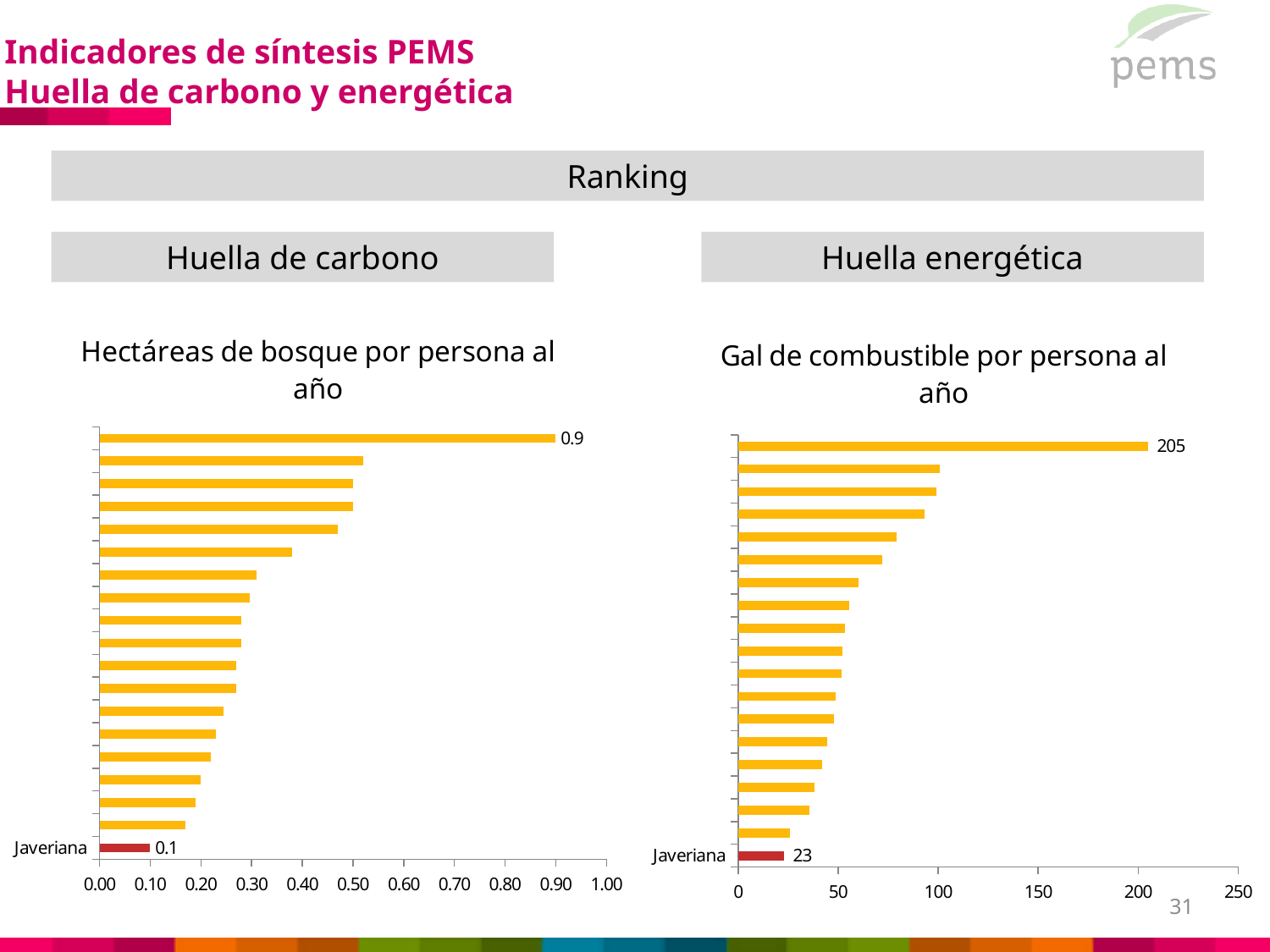
In the 'Hectáreas de bosque por persona al año' chart, what is the value for Javeriana? 0.1 In the 'Gal de combustible por persona al año' chart, what is the value of the longest bar? 205 In the 'Hectáreas de bosque por persona al año' chart, what colour is the Javeriana bar? red In the 'Hectáreas de bosque por persona al año' chart, which labelled category has the lowest value? Javeriana In the 'Hectáreas de bosque por persona al año' chart, what is the difference between the highest value and the value for Javeriana? 0.8 How many bars are plotted in the 'Gal de combustible por persona al año' chart? 19 In the 'Gal de combustible por persona al año' chart, what is the difference between the highest value and the value for Javeriana? 182 What kind of chart is the 'Gal de combustible por persona al año' chart? bar chart In the 'Gal de combustible por persona al año' chart, is the value for Javeriana greater or less than 50? less In the 'Hectáreas de bosque por persona al año' chart, is the value for Javeriana greater or less than 0.20? less In the 'Gal de combustible por persona al año' chart, what is the value for Javeriana? 23 In the 'Hectáreas de bosque por persona al año' chart, what is the value of the longest bar? 0.9